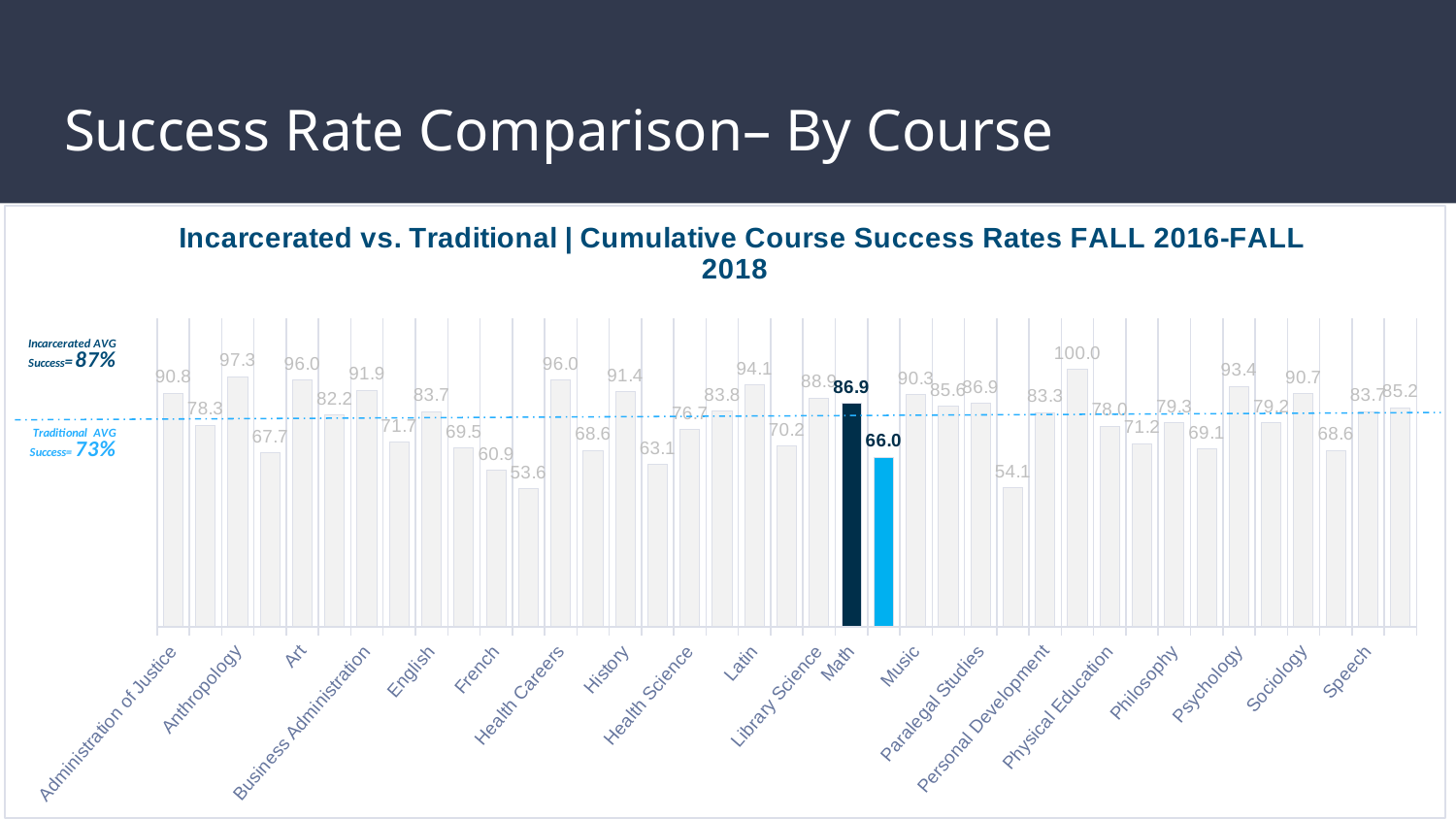
What is the incarcerated success rate for Math (the highlighted dark bar)? 86.9 What is the first bar value for Administration of Justice? 90.8 Which is larger for Math: the incarcerated bar or the traditional bar? Incarcerated bar How many courses are listed along the x axis of the chart? 20 What is the difference between the two Math bars (86.9 and 66.0)? 20.9 What type of chart is shown on the slide? Bar chart What is the title of the chart? Incarcerated vs. Traditional | Cumulative Course Success Rates FALL 2016-FALL 2018 What is the traditional success rate for Math (the highlighted light blue bar)? 66.0 What is the highest value labeled on any bar in the chart? 100.0 What is the lowest value labeled on any bar in the chart? 53.6 What is the Incarcerated AVG Success rate shown on the chart? 87% What is the Traditional AVG Success rate shown on the chart? 73%